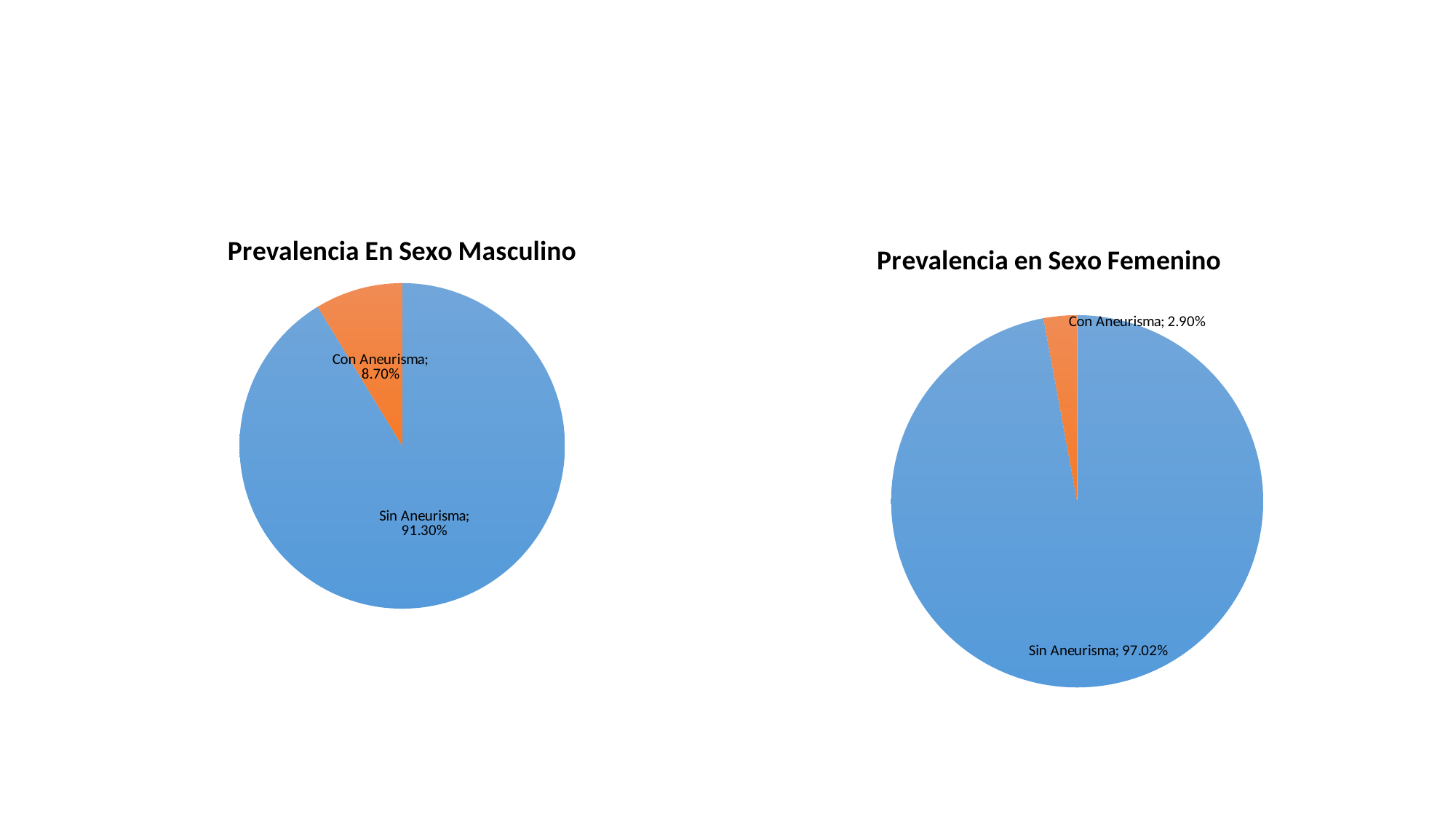
In the 'Prevalencia En Sexo Masculino' chart, which category has the largest slice? Sin Aneurisma In the 'Prevalencia en Sexo Femenino' chart, what is the value for Sin Aneurisma? 97.02% In the 'Prevalencia En Sexo Masculino' chart, what is the value for Sin Aneurisma? 91.30% In the 'Prevalencia en Sexo Femenino' chart, what share of the pie does Sin Aneurisma represent? 97.02% In the 'Prevalencia en Sexo Femenino' chart, which category has the smallest slice? Con Aneurisma In the 'Prevalencia En Sexo Masculino' chart, what is the difference between Sin Aneurisma and Con Aneurisma? 82.60% What colour is the Con Aneurisma slice in the 'Prevalencia En Sexo Masculino' chart? Orange Which chart shows a larger value for Con Aneurisma, 'Prevalencia En Sexo Masculino' or 'Prevalencia en Sexo Femenino'? Prevalencia En Sexo Masculino What type of chart is 'Prevalencia en Sexo Femenino'? Pie chart In the 'Prevalencia en Sexo Femenino' chart, what is the value for Con Aneurisma? 2.90% How many categories are shown in the 'Prevalencia En Sexo Masculino' chart? 2 In the 'Prevalencia En Sexo Masculino' chart, what is the value for Con Aneurisma? 8.70%